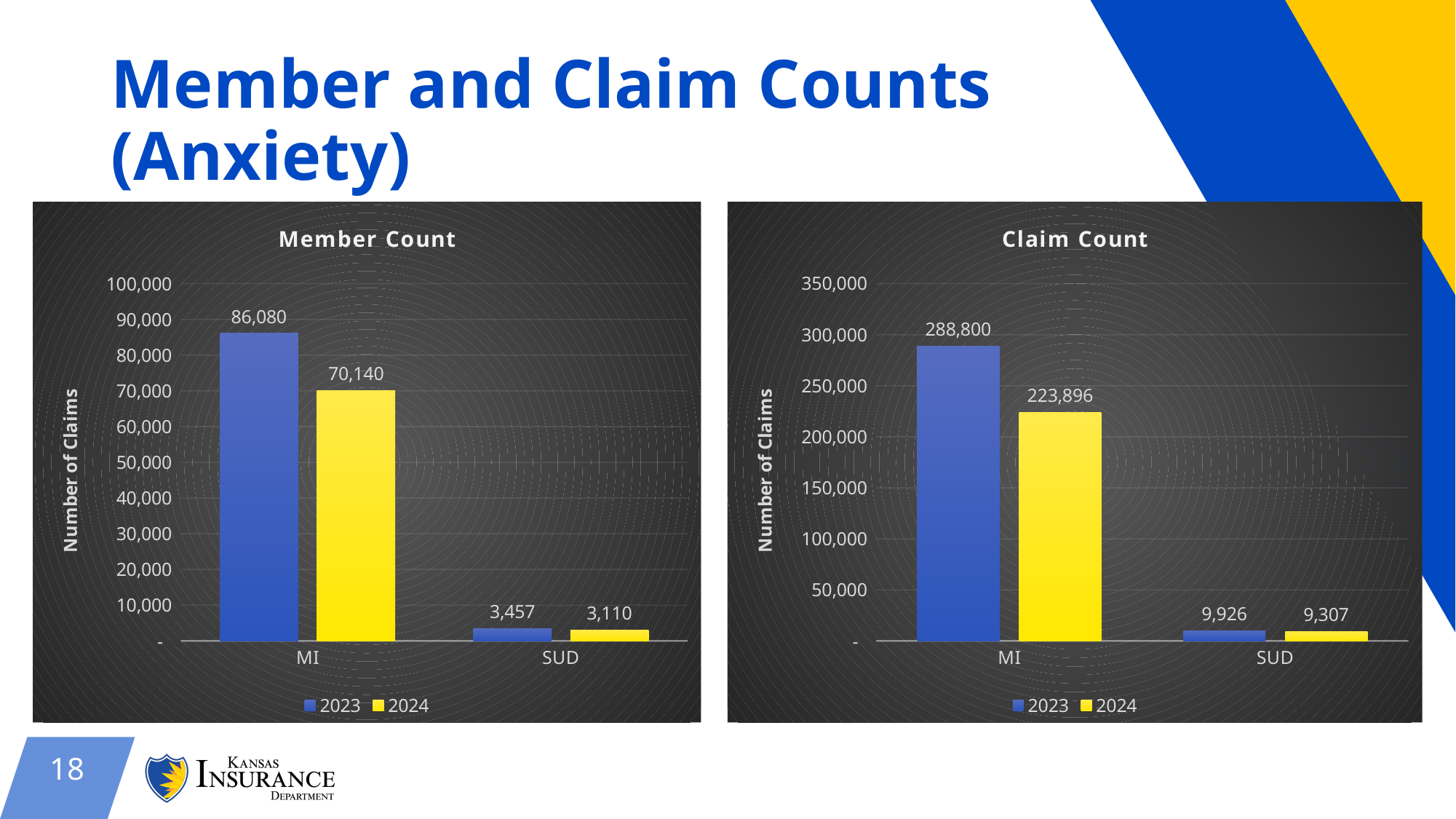
In the Claim Count chart, what is the value for MI in 2024? 223,896 How many series does the legend of the Claim Count chart list? 2 In the Member Count chart, which category has the lowest value in 2024? SUD In the Member Count chart, is the 2023 value for MI greater or less than 80,000? greater In the Claim Count chart, which category has the highest value in 2023? MI In the Member Count chart, what is the difference between the 2023 and 2024 values for MI? 15,940 In the Claim Count chart, what is the difference between the 2023 and 2024 values for MI? 64,904 What kind of chart is the Member Count chart? bar chart In the Claim Count chart, what is the value for SUD in 2023? 9,926 What is the y-axis label of the Claim Count chart? Number of Claims In the Member Count chart, what is the value for SUD in 2024? 3,110 In the Member Count chart, what is the value for MI in 2023? 86,080